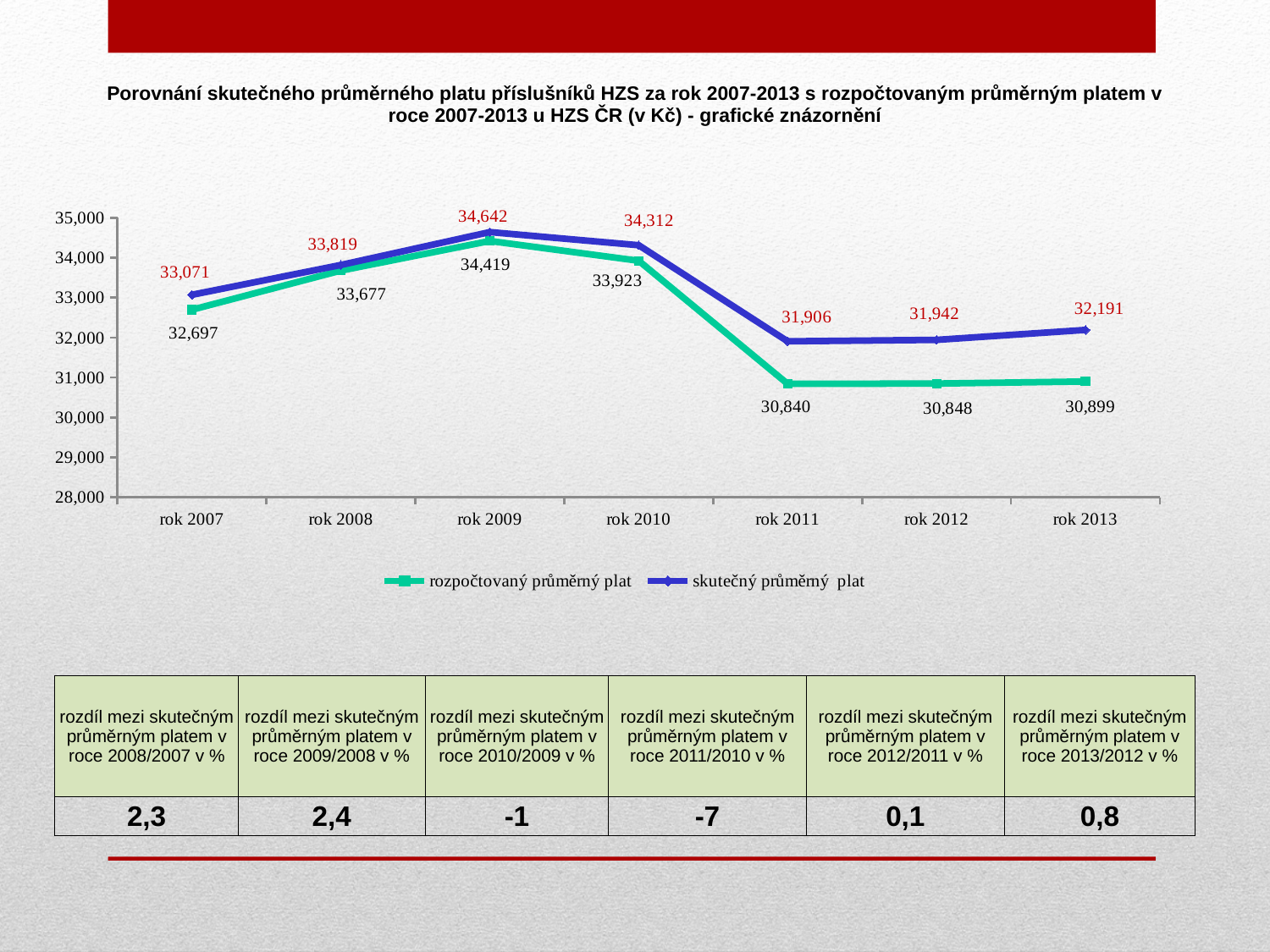
How many series does the chart legend list? 2 In which year is skutečný průměrný plat lowest? rok 2011 What is the value of rozpočtovaný průměrný plat for rok 2011? 30,840 Is the value of rozpočtovaný průměrný plat for rok 2012 greater or less than 31,000? less What is the difference between skutečný průměrný plat and rozpočtovaný průměrný plat in rok 2010? 389 How many years are shown on the x axis of the chart? 7 What is the value of skutečný průměrný plat for rok 2009? 34,642 Does skutečný průměrný plat rise or fall from rok 2010 to rok 2011? fall In which year is rozpočtovaný průměrný plat highest? rok 2009 Which is larger in rok 2007: skutečný průměrný plat or rozpočtovaný průměrný plat? skutečný průměrný plat What kind of chart is shown on the slide? line chart What is the value of skutečný průměrný plat for rok 2013? 32,191